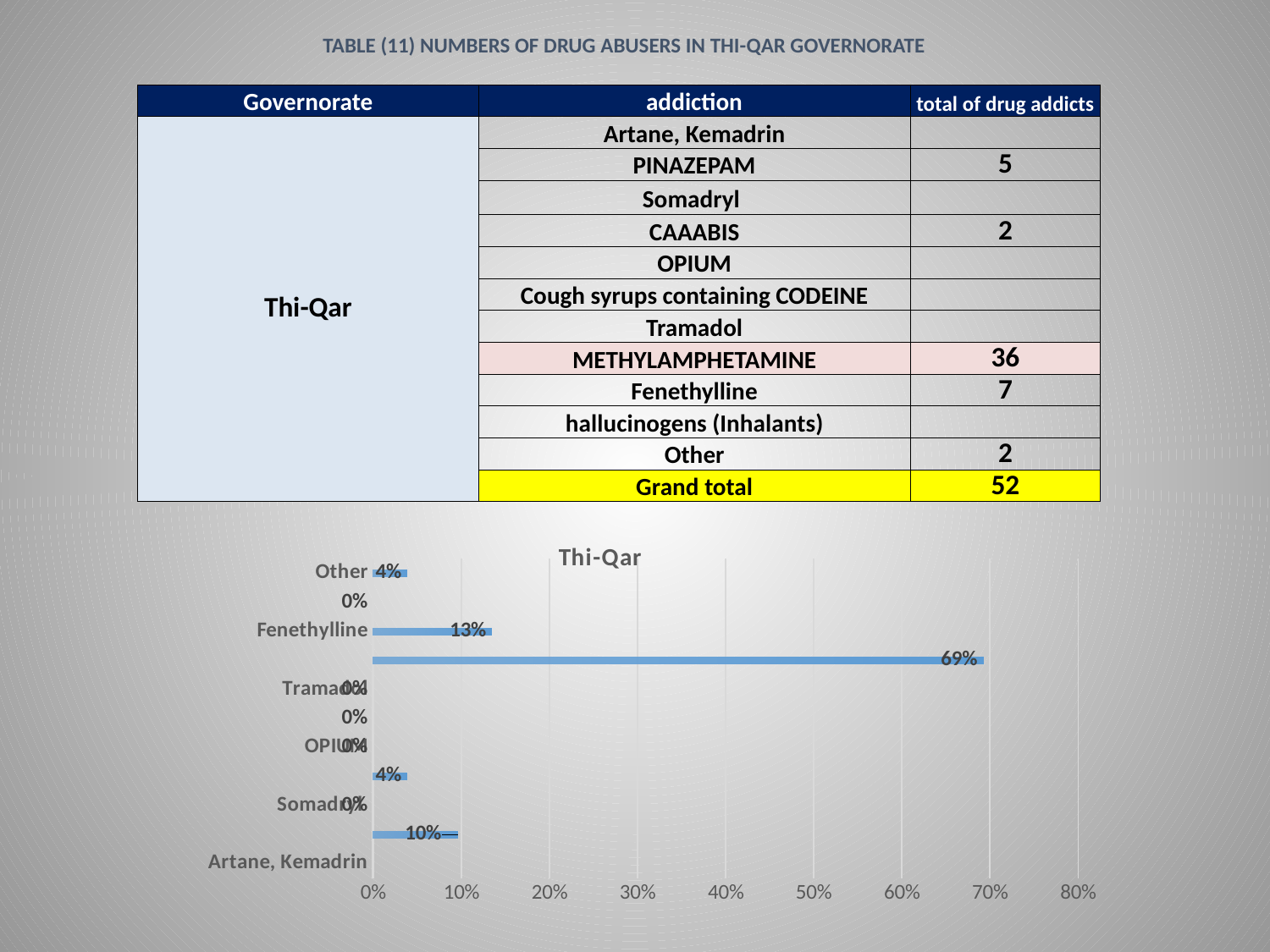
What is the value for Other in the chart? 4% What type of chart is shown on the slide? bar chart What is the value for Somadryl in the chart? 0% What is the difference between the value for Fenethylline and the value for Other? 9% What is the highest value shown on the chart's horizontal axis? 80% Is the longest bar in the chart greater or less than 60%? greater Which is larger in the chart, the value for Fenethylline or the value for Other? Fenethylline What is the value for OPIUM in the chart? 0% What is the value for Fenethylline in the chart? 13% What is the value for Tramadol in the chart? 0% What is the largest value shown in the chart? 69% What is the title of the chart? Thi-Qar